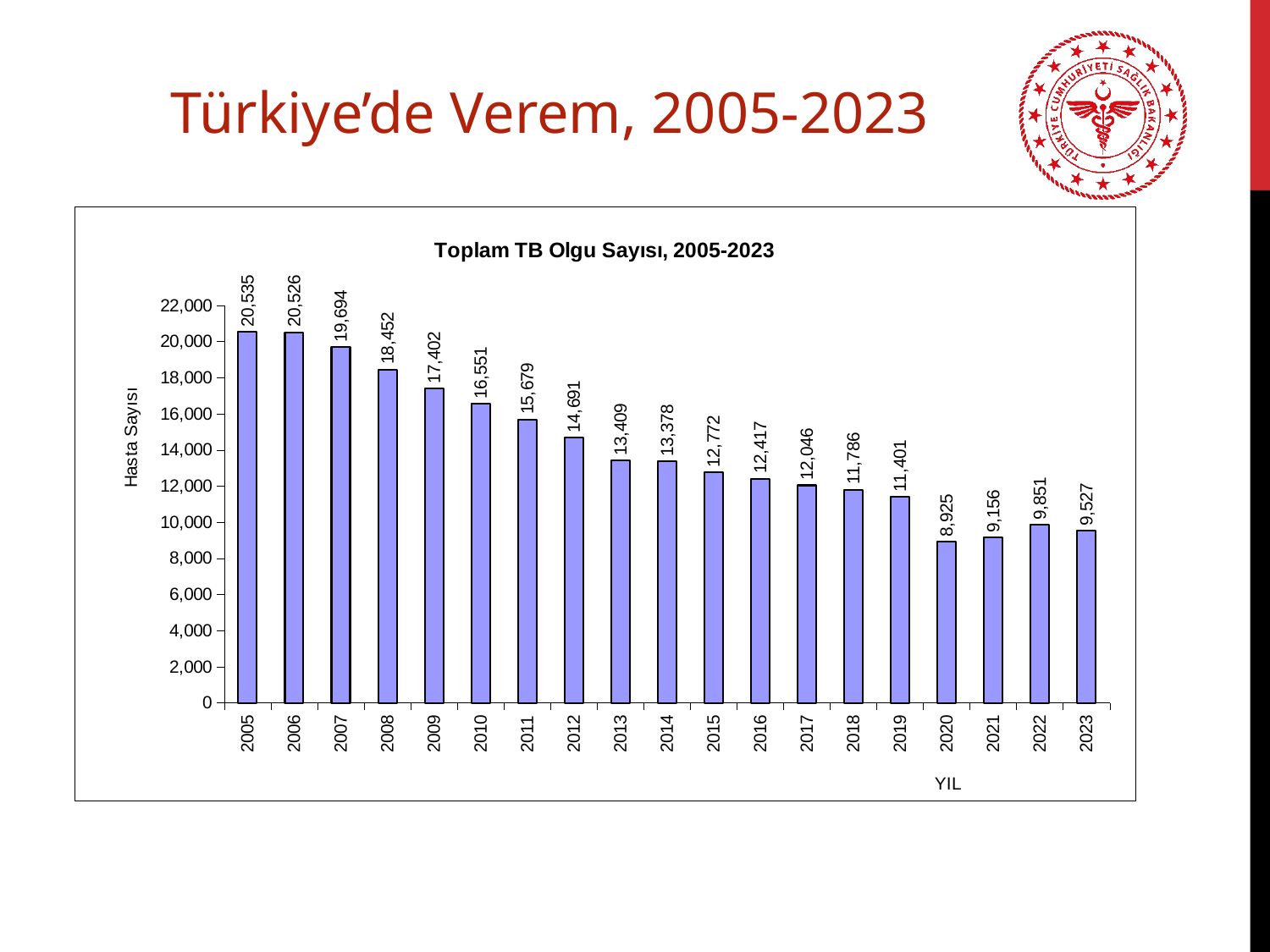
How many years are shown on the x axis? 19 What is the title of the chart? Toplam TB Olgu Sayısı, 2005-2023 Which year has the highest number of cases? 2005 Is the value for 2012 greater or less than 14,000? greater What kind of chart is this? Bar chart Which year has the lowest number of cases? 2020 Do the values generally rise or fall from 2005 to 2020? Fall What is the value shown for 2023? 9,527 What is the total TB case count for 2005? 20,535 Which year has a larger value, 2021 or 2022? 2022 What is the difference between the values for 2005 and 2023? 11,008 What is the value shown for 2020? 8,925